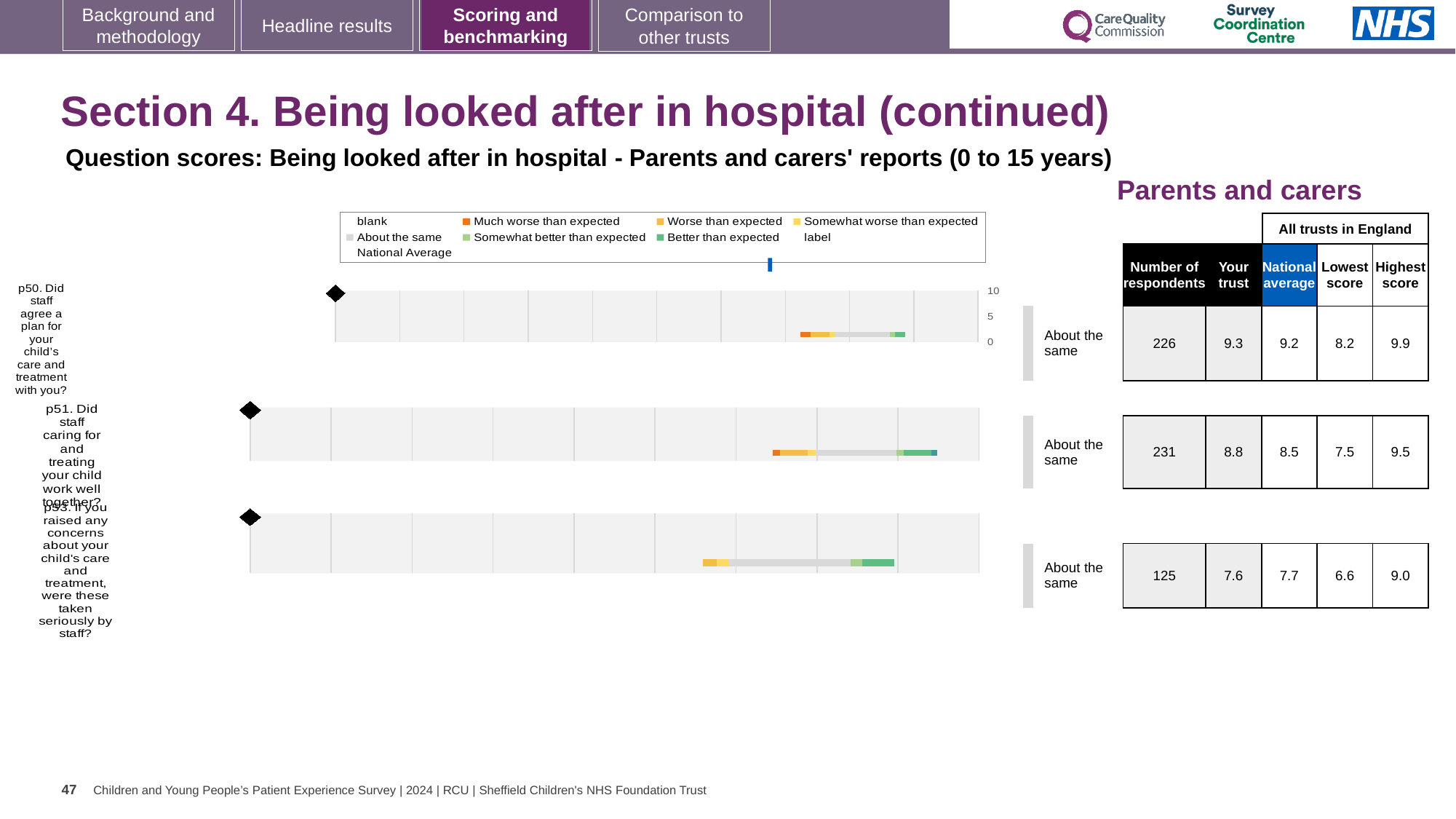
What benchmark category is shown next to the p51 chart? About the same In the table beside the charts, how many respondents answered p51? 231 Which question has the lowest 'Your trust' score in the table beside the charts? p53 In the table beside the charts, what is the national average for p53 (If you raised any concerns about your child's care and treatment, were these taken seriously by staff?)? 7.7 What is the highest tick value shown on the axis of the p50 chart? 10 In the table beside the charts, is the 'Your trust' score for p51 larger or smaller than the national average for p51? larger What kind of chart is used for the p50 question on the slide? bar chart In the table beside the charts, what is the 'Your trust' score for p50 (Did staff agree a plan for your child's care and treatment with you?)? 9.3 In the table beside the charts, what is the difference between the highest score and the lowest score for p50? 1.7 How many question charts (p50, p51, p53) are shown on the slide? 3 What is the last entry listed in the chart legend? National Average Which question has the highest number of respondents in the table beside the charts? p51